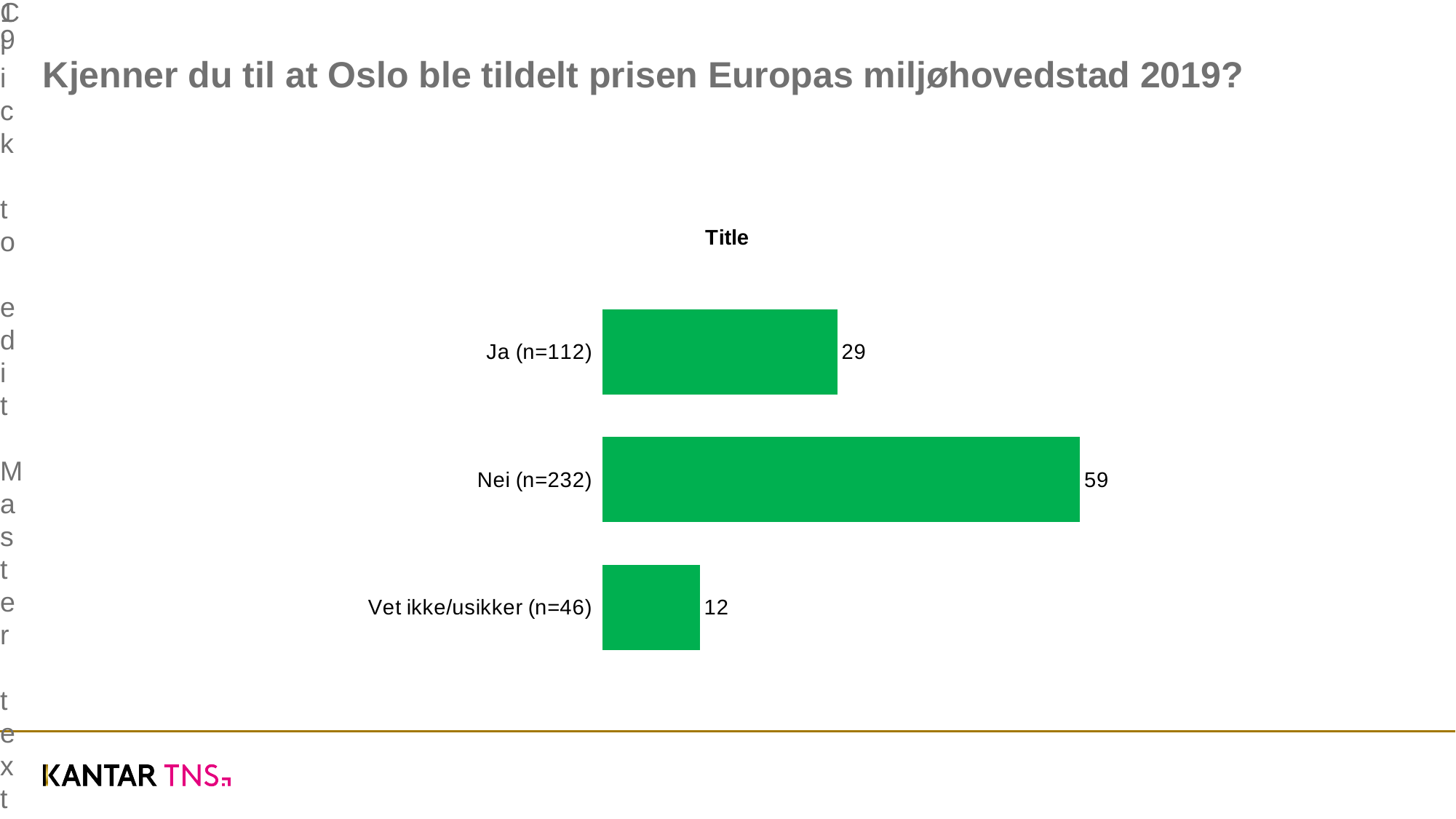
What is the value for Ja (n=112)? 29 What is the value for Vet ikke/usikker (n=46)? 12 What is the value for Nei (n=232)? 59 What colour are the bars in the chart? Green What is the title shown above the chart? Title Which category has the lowest value? Vet ikke/usikker (n=46) Which category has the highest value? Nei (n=232) How many categories are shown in the chart? 3 What is the difference between the values for Nei (n=232) and Ja (n=112)? 30 What is the difference between the values for Ja (n=112) and Vet ikke/usikker (n=46)? 17 Which is larger, the value for Ja (n=112) or the value for Vet ikke/usikker (n=46)? Ja (n=112) What kind of chart is shown on the slide? Bar chart